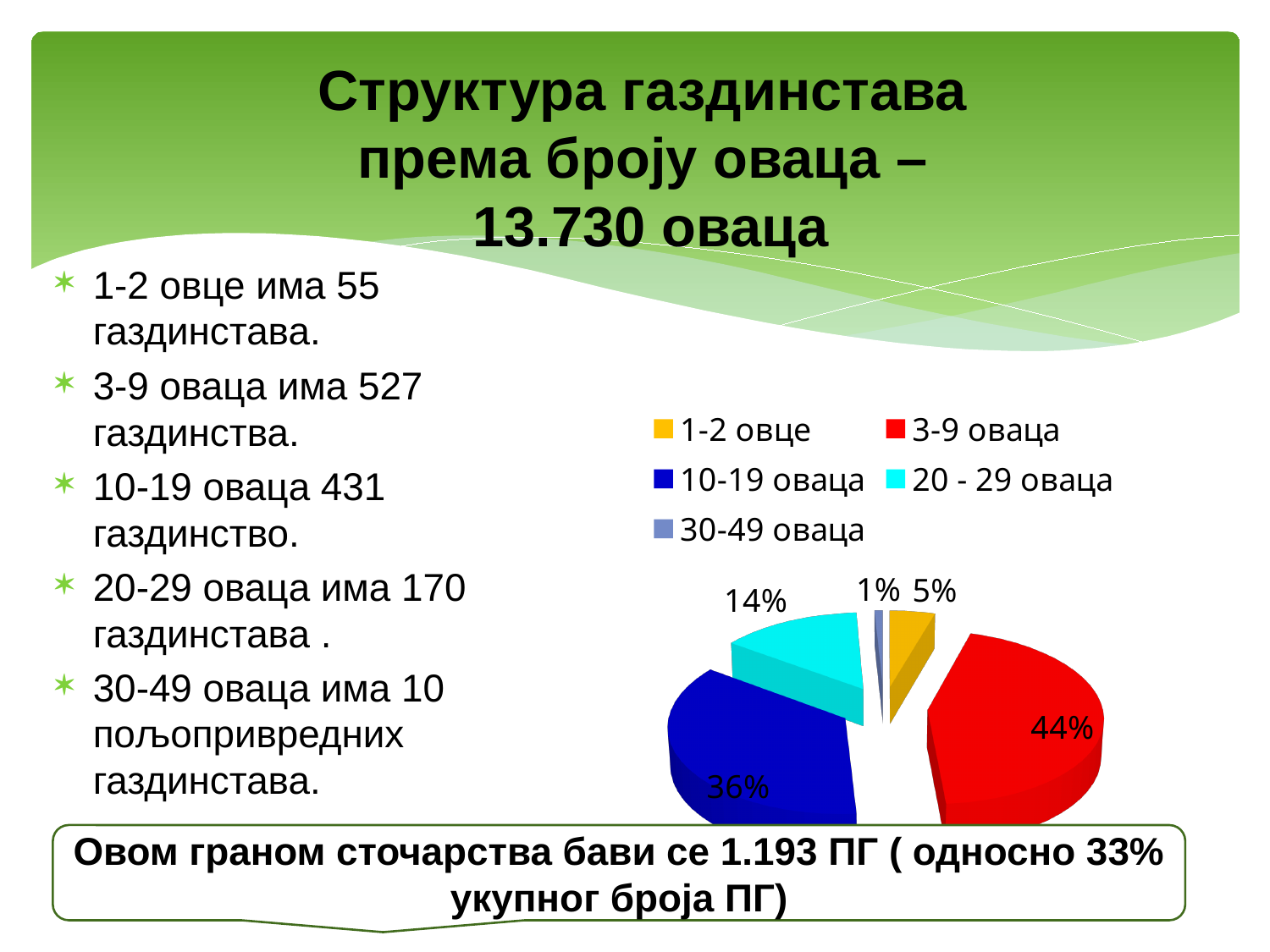
What kind of chart is shown on the slide? pie chart What share of the pie does the '20 - 29 оваца' slice represent? 14% How many entries does the legend of the pie chart list? 5 What share of the pie does the '10-19 оваца' slice represent? 36% What share of the pie does the '3-9 оваца' slice represent? 44% Which colour represents the '20 - 29 оваца' category in the pie chart? cyan Which category has the smallest slice in the pie chart? 30-49 оваца What is the difference in percentage points between the '3-9 оваца' slice and the '10-19 оваца' slice? 8 How many slices does the pie chart have? 5 Which category has the largest slice in the pie chart? 3-9 оваца